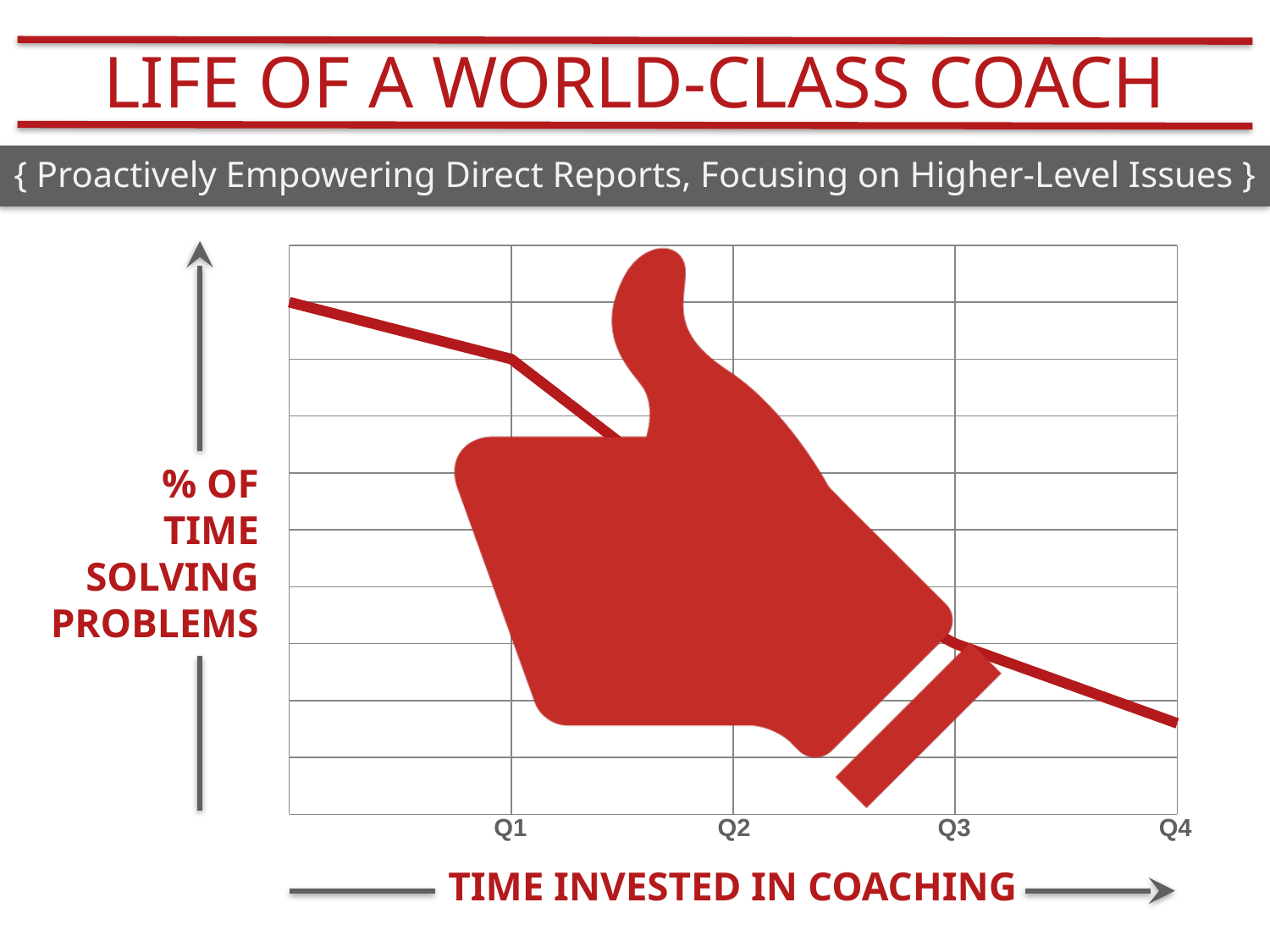
What is the label of the x axis? TIME INVESTED IN COACHING Which is higher, the value at Q1 or the value at Q4? Q1 Which labelled quarter has the lowest value for % of time solving problems? Q4 What is the label of the y axis? % OF TIME SOLVING PROBLEMS How many quarters are labelled on the x axis? 4 Which is higher, the value at Q3 or the value at Q4? Q3 Which labelled quarter has the highest value for % of time solving problems? Q1 What kind of chart is shown on the slide? line chart Which is higher, the value at Q1 or the value at Q3? Q1 Does the line rise or fall as time invested in coaching increases from Q1 to Q4? fall